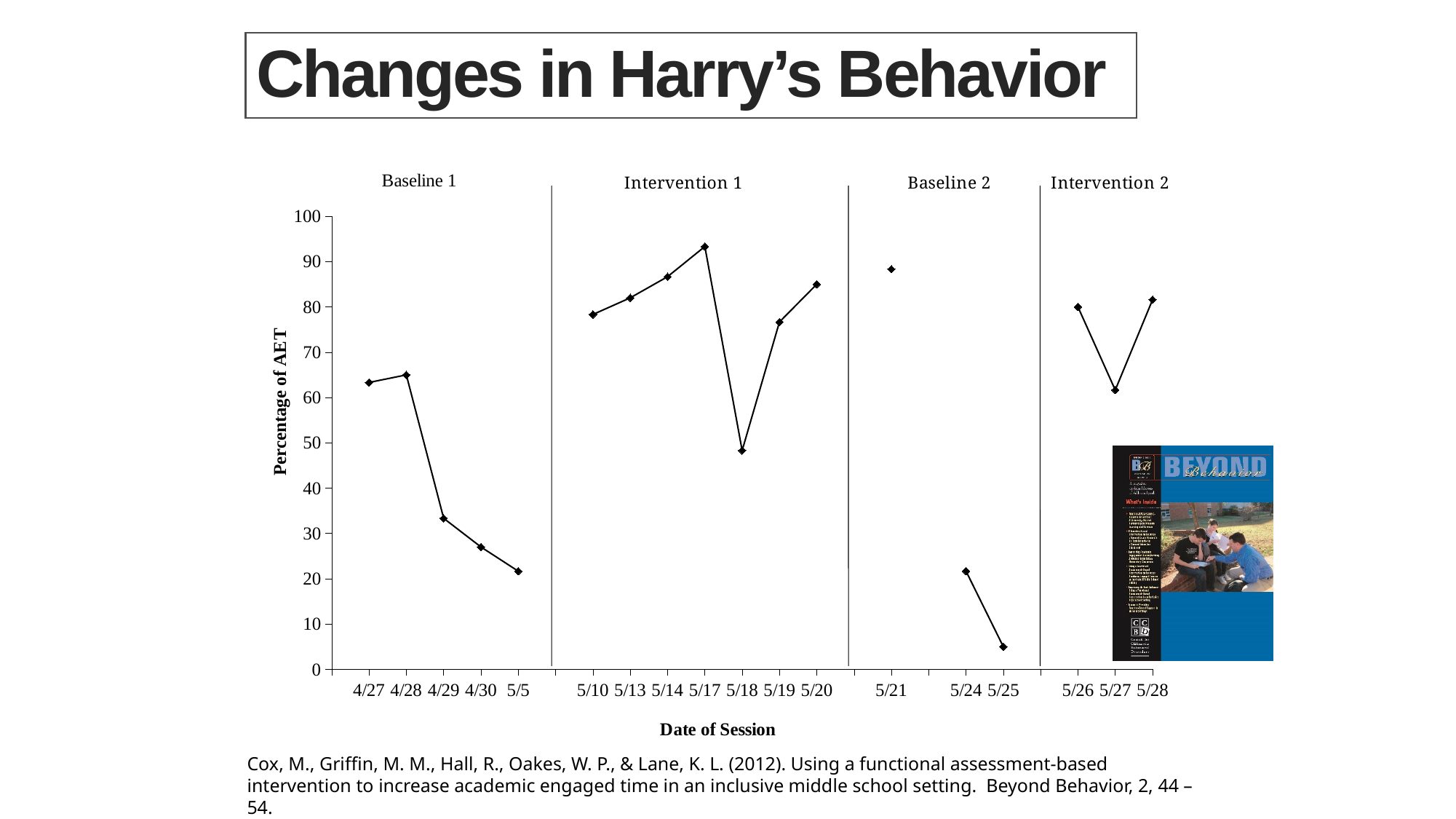
On which session date is the percentage of AET lowest? 5/25 Is the value for 5/18 greater or less than 60? less How many session dates are plotted along the x axis? 18 Is the value for 5/25 greater or less than 10? less What is the label on the y axis of the chart? Percentage of AET Is the value for 4/27 greater or less than 60? greater Do the values rise or fall across the Baseline 1 phase from 4/27 to 5/5? fall Which session has the higher percentage of AET, 5/26 or 5/27? 5/26 What kind of chart is shown on the slide? line chart Which session has the higher percentage of AET, 4/28 or 4/29? 4/28 On which session date is the percentage of AET highest? 5/17